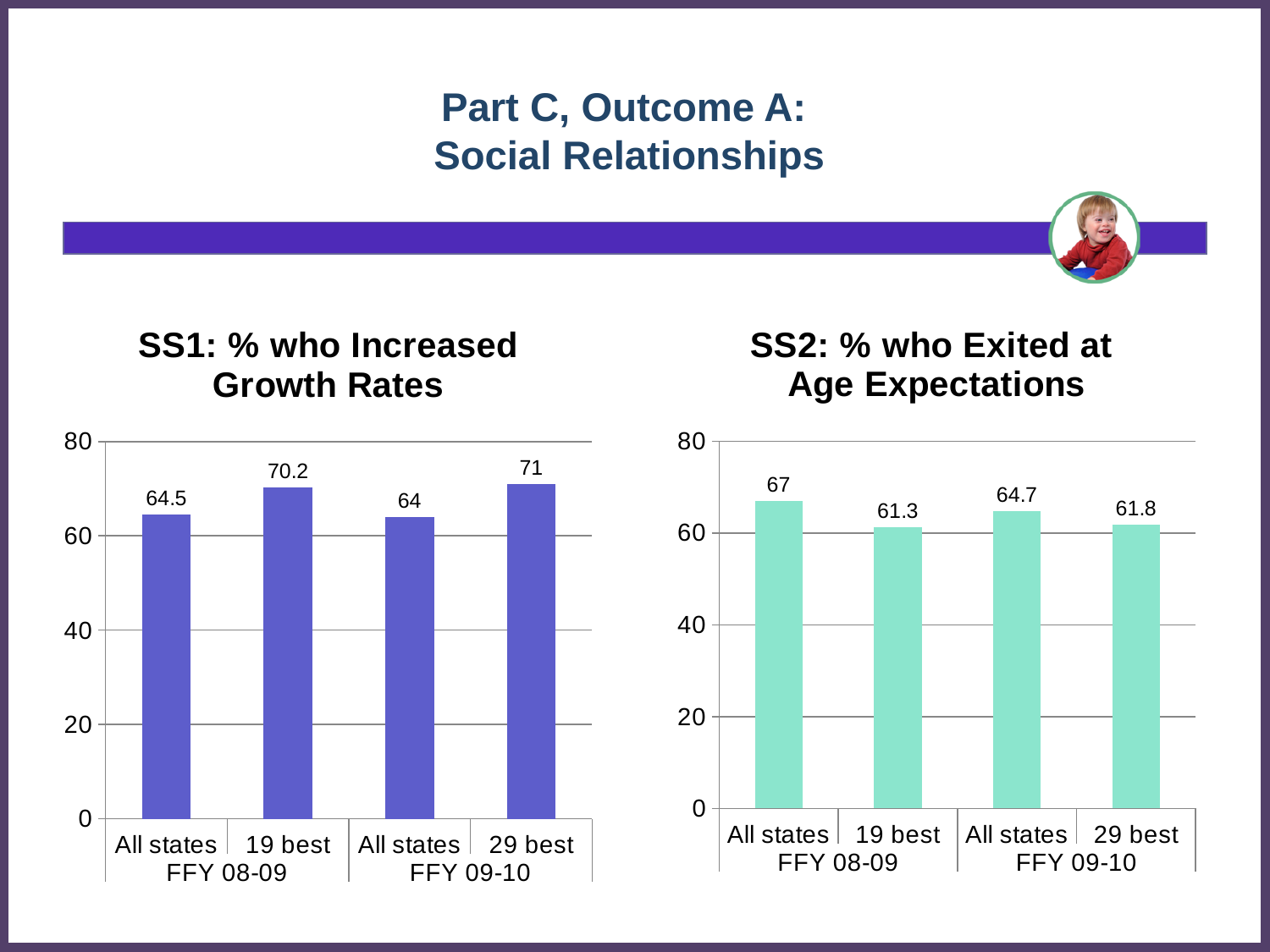
In the SS1: % who Increased Growth Rates chart, what is the value for 29 best in FFY 09-10? 71 In the SS1: % who Increased Growth Rates chart, what is the value for All states in FFY 08-09? 64.5 In the SS1: % who Increased Growth Rates chart, what is the difference between the 19 best value in FFY 08-09 and the All states value in FFY 08-09? 5.7 In the SS2: % who Exited at Age Expectations chart, what is the value for 19 best in FFY 08-09? 61.3 How many bars are plotted in the SS1: % who Increased Growth Rates chart? 4 In the SS2: % who Exited at Age Expectations chart, which bar has the lowest value? 19 best, FFY 08-09 In the SS2: % who Exited at Age Expectations chart, what is the difference between the All states value in FFY 08-09 and the 29 best value in FFY 09-10? 5.2 In the SS1: % who Increased Growth Rates chart, which bar has the highest value? 29 best, FFY 09-10 In the SS2: % who Exited at Age Expectations chart, which is larger: All states in FFY 08-09 or All states in FFY 09-10? All states in FFY 08-09 What kind of chart is the SS2: % who Exited at Age Expectations chart? Bar chart In the SS2: % who Exited at Age Expectations chart, what is the value for All states in FFY 09-10? 64.7 What is the maximum value shown on the y axis of the SS1: % who Increased Growth Rates chart? 80